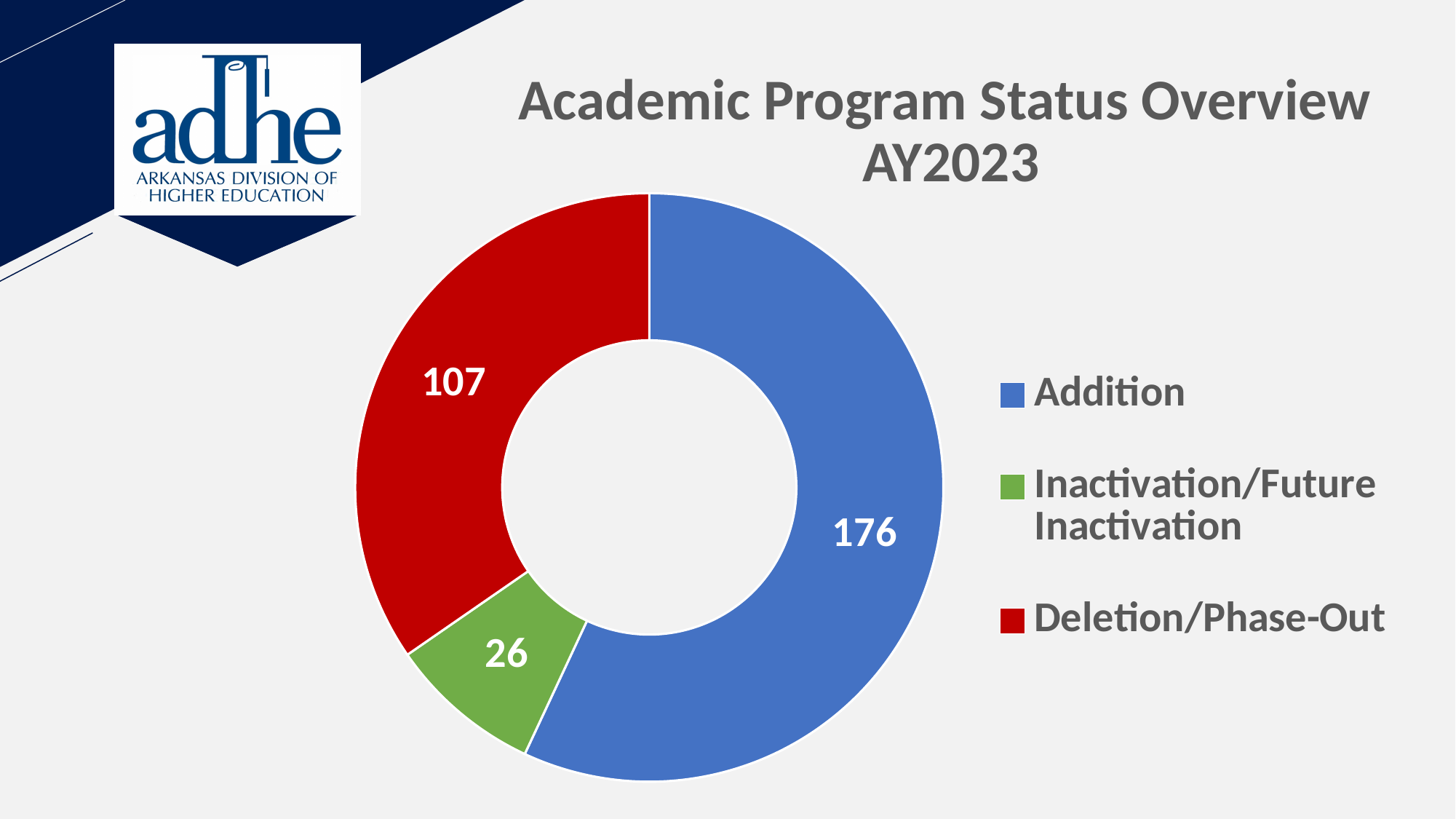
What is the value for Addition? 176 Which is larger, the value for Deletion/Phase-Out or the value for Inactivation/Future Inactivation? Deletion/Phase-Out What kind of chart is shown on the slide? Doughnut chart Which category has the highest value? Addition What is the difference between the values for Deletion/Phase-Out and Inactivation/Future Inactivation? 81 What is the difference between the values for Addition and Deletion/Phase-Out? 69 Which category has the lowest value? Inactivation/Future Inactivation What is the value for Inactivation/Future Inactivation? 26 What is the value for Deletion/Phase-Out? 107 How many categories does the chart show? 3 What is the total of all the values shown in the chart? 309 What is the title of the chart? Academic Program Status Overview AY2023